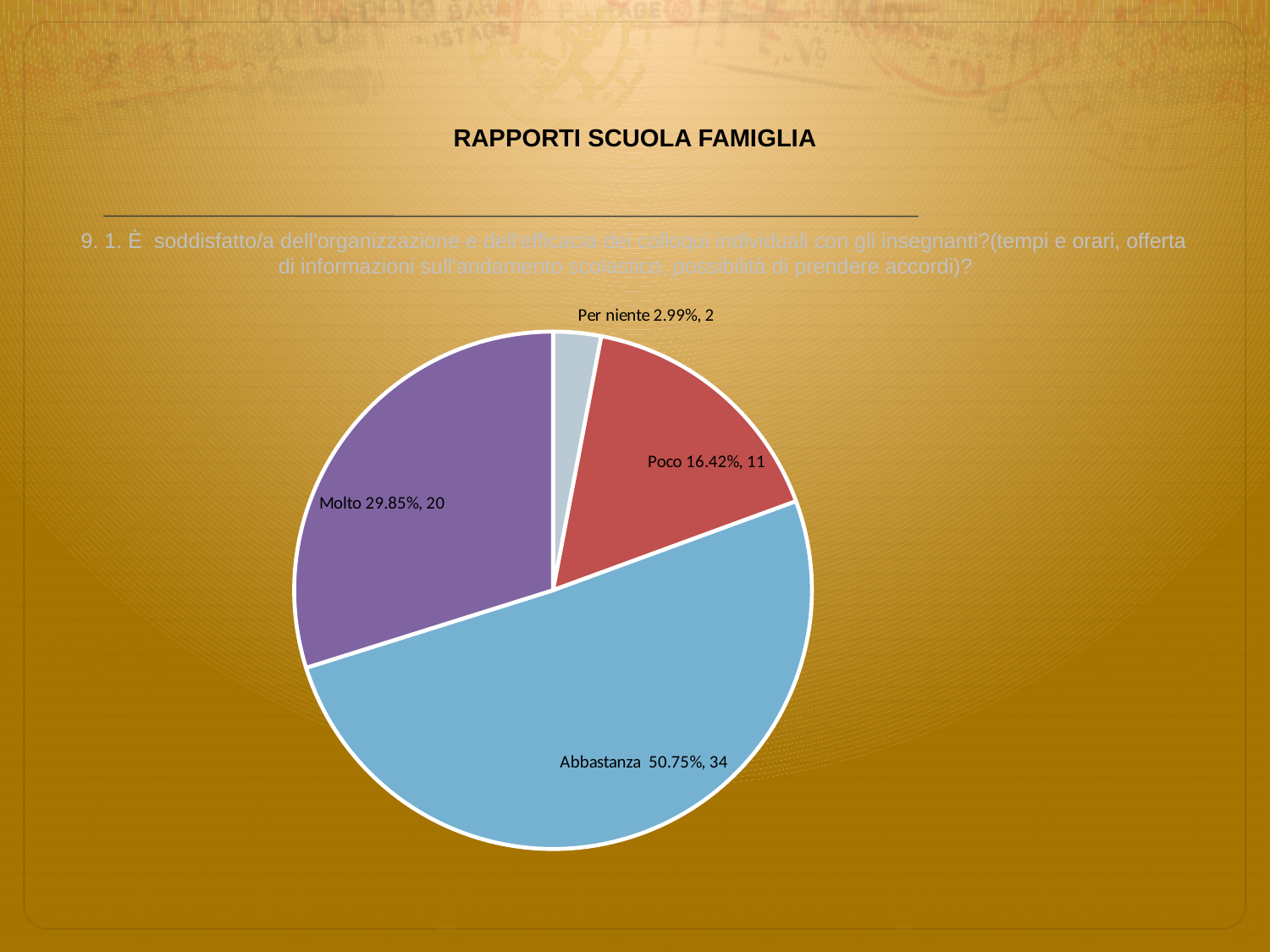
What percentage share does the Poco slice have? 16.42% Which category has the smallest slice? Per niente What kind of chart is shown on the slide? pie chart Which is larger, the Molto slice or the Poco slice? Molto What is the difference in count between Abbastanza and Molto? 14 What is the count value shown for Per niente? 2 Which category has the largest slice? Abbastanza What is the total count across all slices? 67 How many slices does the pie chart have? 4 What percentage share does the Abbastanza slice have? 50.75% What colour is the Abbastanza slice? blue What is the count value shown for Molto? 20